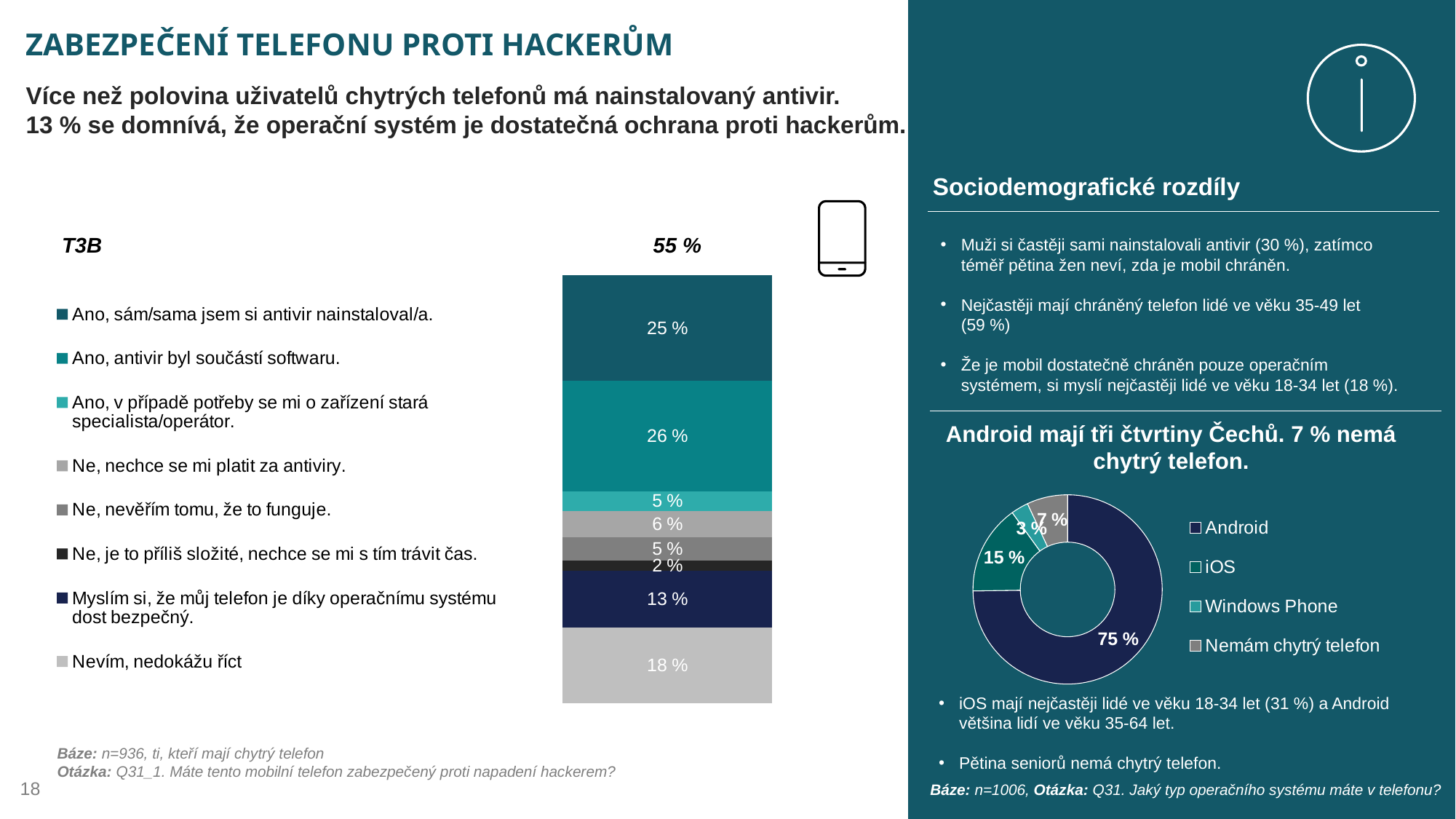
In the stacked bar chart on the left, what percentage is shown for "Ano, antivir byl součástí softwaru."? 26 % In the donut chart on the right, what is the difference between the shares for "Nemám chytrý telefon" and Windows Phone? 4 % In the donut chart on the right, what share is shown for Android? 75 % In the stacked bar chart on the left, which category has the smallest segment? Ne, je to příliš složité, nechce se mi s tím trávit čas. In the stacked bar chart on the left, which category has the largest segment? Ano, antivir byl součástí softwaru. In the stacked bar chart on the left, what T3B value is shown above the bar? 55 % In the stacked bar chart on the left, what percentage is shown for "Nevím, nedokážu říct"? 18 % In the donut chart on the right, what share is shown for iOS? 15 % In the stacked bar chart on the left, what is the difference between "Nevím, nedokážu říct" and "Myslím si, že můj telefon je díky operačnímu systému dost bezpečný."? 5 % In the stacked bar chart on the left, what percentage is shown for "Myslím si, že můj telefon je díky operačnímu systému dost bezpečný."? 13 % In the donut chart on the right, which category has the smallest share? Windows Phone In the stacked bar chart on the left, how many categories does the legend list? 8